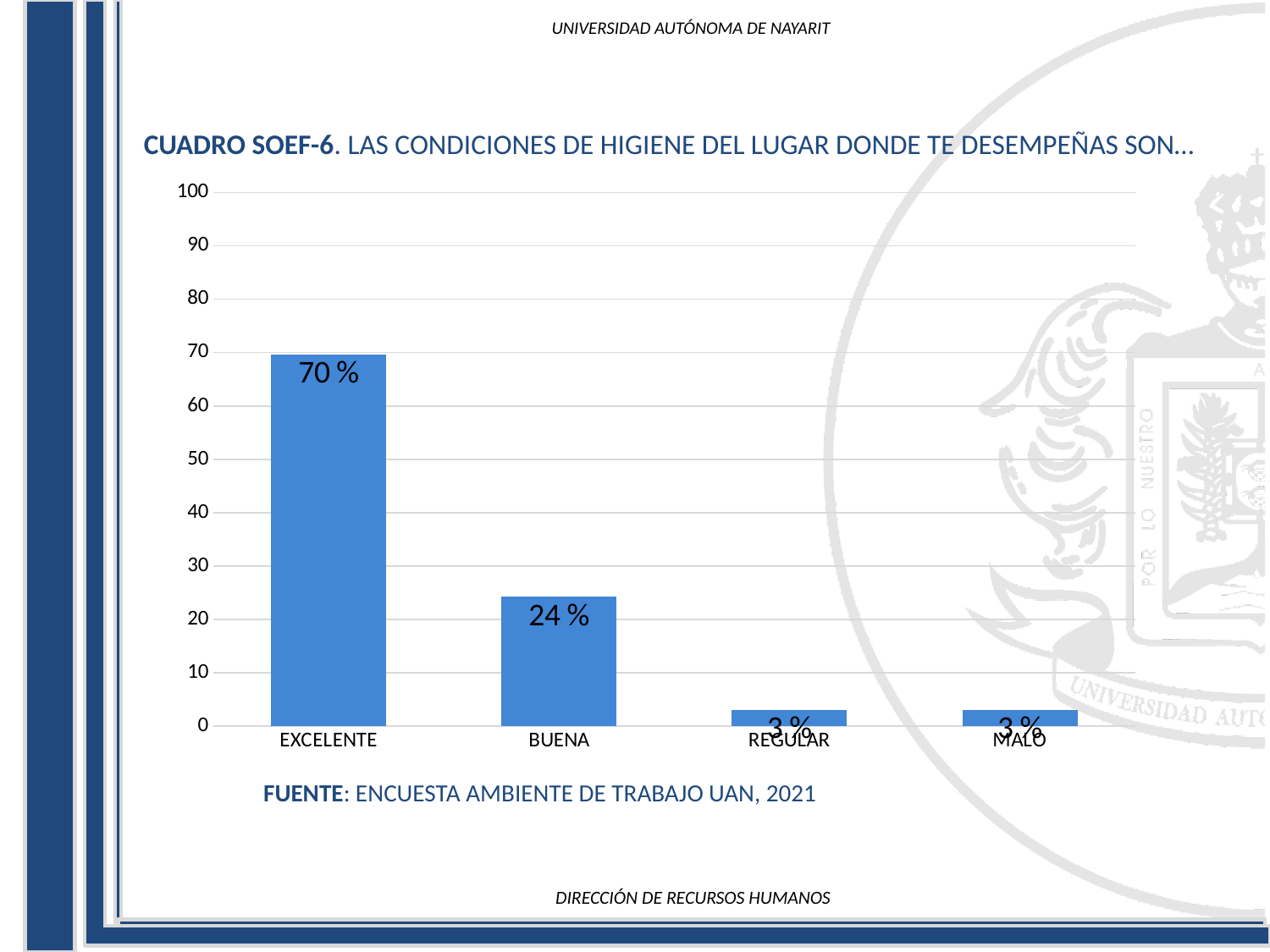
Is the value for BUENA greater or less than 30? less What is the value for MALO? 3 % What is the value for REGULAR? 3 % Do the values rise or fall from EXCELENTE to REGULAR along the x axis? fall What is the difference between the values for EXCELENTE and BUENA? 46 % What kind of chart is shown on the slide? bar chart How many categories are shown on the x axis? 4 What is the value for EXCELENTE? 70 % Which category has the highest value? EXCELENTE What is the value for BUENA? 24 % Which is larger, the value for BUENA or the value for REGULAR? BUENA What source is cited below the chart? ENCUESTA AMBIENTE DE TRABAJO UAN, 2021